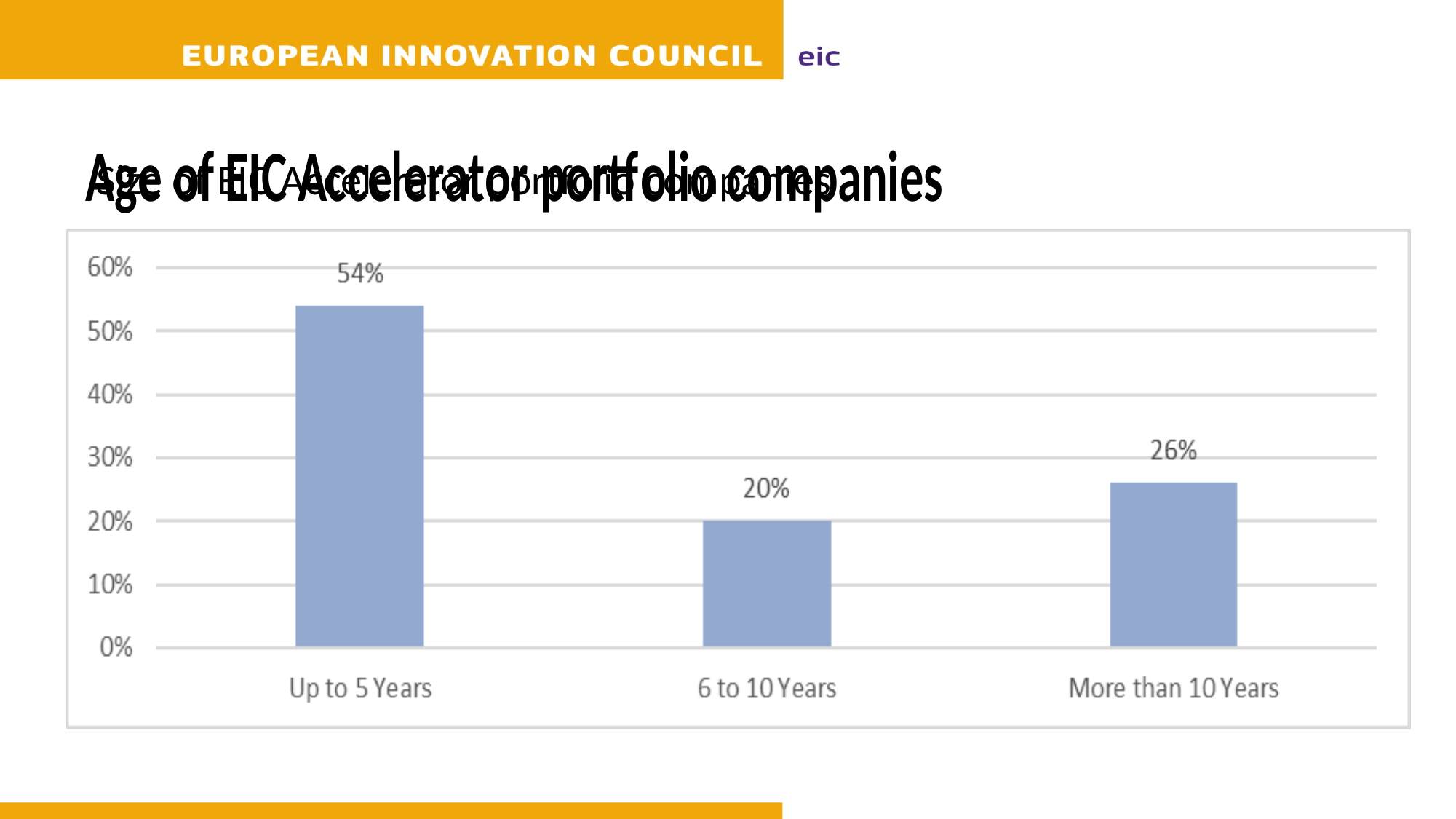
Which age category has the lowest share of companies? 6 to 10 Years What is the difference between the 'Up to 5 Years' and 'More than 10 Years' values? 28% Is the value for 'Up to 5 Years' greater or less than 50%? greater What is the value shown for the '6 to 10 Years' category? 20% What kind of chart is shown on the slide? Bar chart What percentage of EIC Accelerator portfolio companies are up to 5 years old? 54% What is the value shown for the 'More than 10 Years' category? 26% Which age category has the highest share of companies? Up to 5 Years Which is larger: the value for '6 to 10 Years' or for 'More than 10 Years'? More than 10 Years What is the title of the slide? Age of EIC Accelerator portfolio companies How many age categories are shown on the chart? 3 What is the difference between the 'More than 10 Years' and '6 to 10 Years' values? 6%